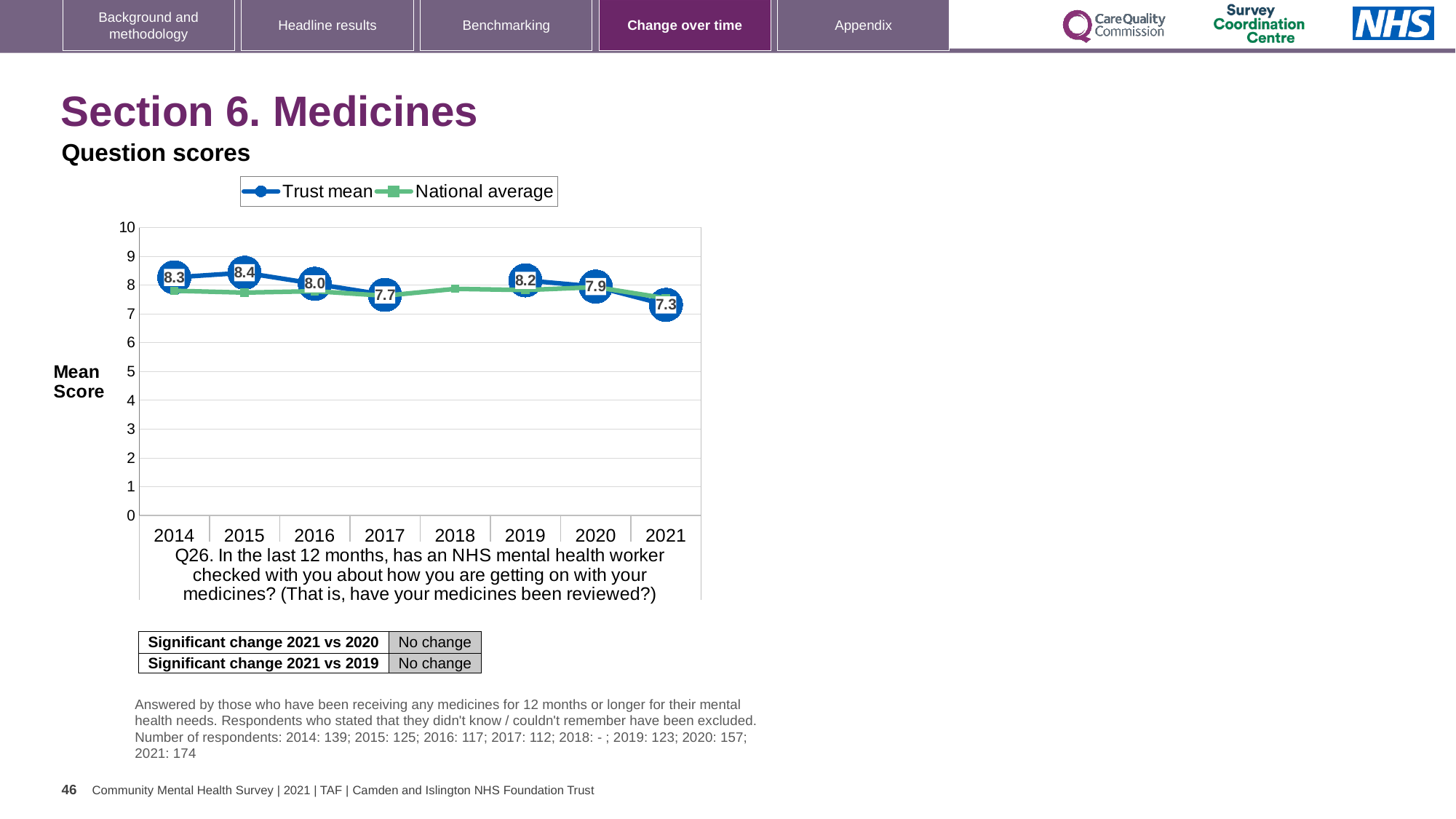
What is the Trust mean score for 2021? 7.3 What kind of chart is shown on the slide? Line chart What is the Trust mean score for 2015? 8.4 Is the National average value for 2018 greater or less than 7? greater Which year has the larger Trust mean score, 2019 or 2020? 2019 Does the Trust mean score rise or fall from 2019 to 2021? Fall In which year is the Trust mean score highest? 2015 What is the difference between the Trust mean score in 2015 and in 2021? 1.1 How many years are shown on the x axis of the chart? 8 In which year is the Trust mean score lowest? 2021 How many series does the chart legend list? 2 What is the Trust mean score for 2017? 7.7